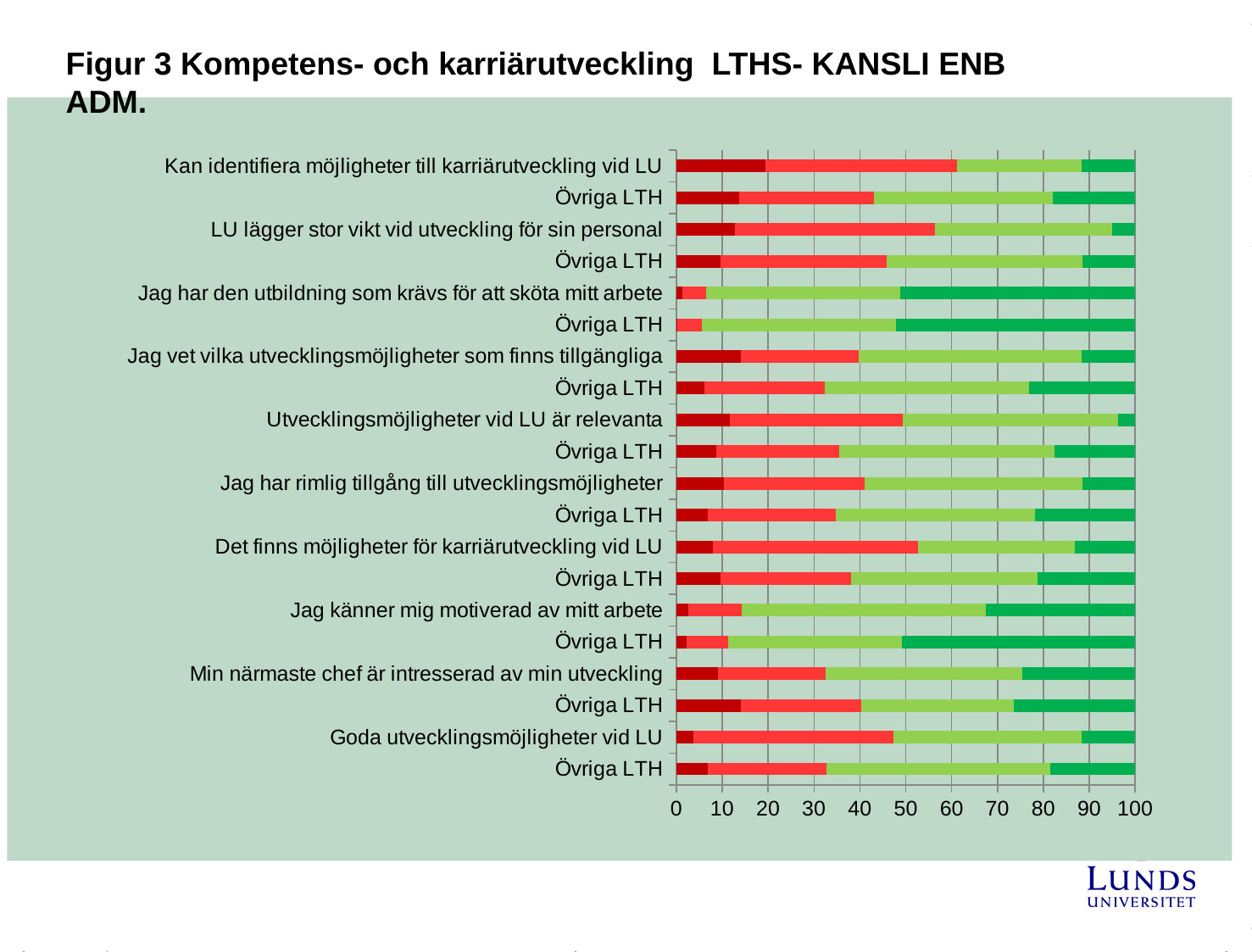
What is the highest value shown on the horizontal axis? 100 What kind of chart is shown on the slide? Stacked bar chart Is the combined red portion (dark red plus red) for "Jag känner mig motiverad av mitt arbete" greater or less than 20? less What is the title of the slide? Figur 3 Kompetens- och karriärutveckling LTHS- KANSLI ENB ADM. Is the combined red portion (dark red plus red) for "Kan identifiera möjligheter till karriärutveckling vid LU" greater or less than 50? greater How many bars (categories) are plotted in the chart? 20 Which has the larger dark red segment: "Kan identifiera möjligheter till karriärutveckling vid LU" or "Jag har den utbildning som krävs för att sköta mitt arbete"? Kan identifiera möjligheter till karriärutveckling vid LU Is the dark red segment for "Kan identifiera möjligheter till karriärutveckling vid LU" greater or less than 10? greater What is the interval between tick marks on the horizontal axis? 10 How many coloured segments make up each bar? 4 How many bars are labelled "Övriga LTH"? 10